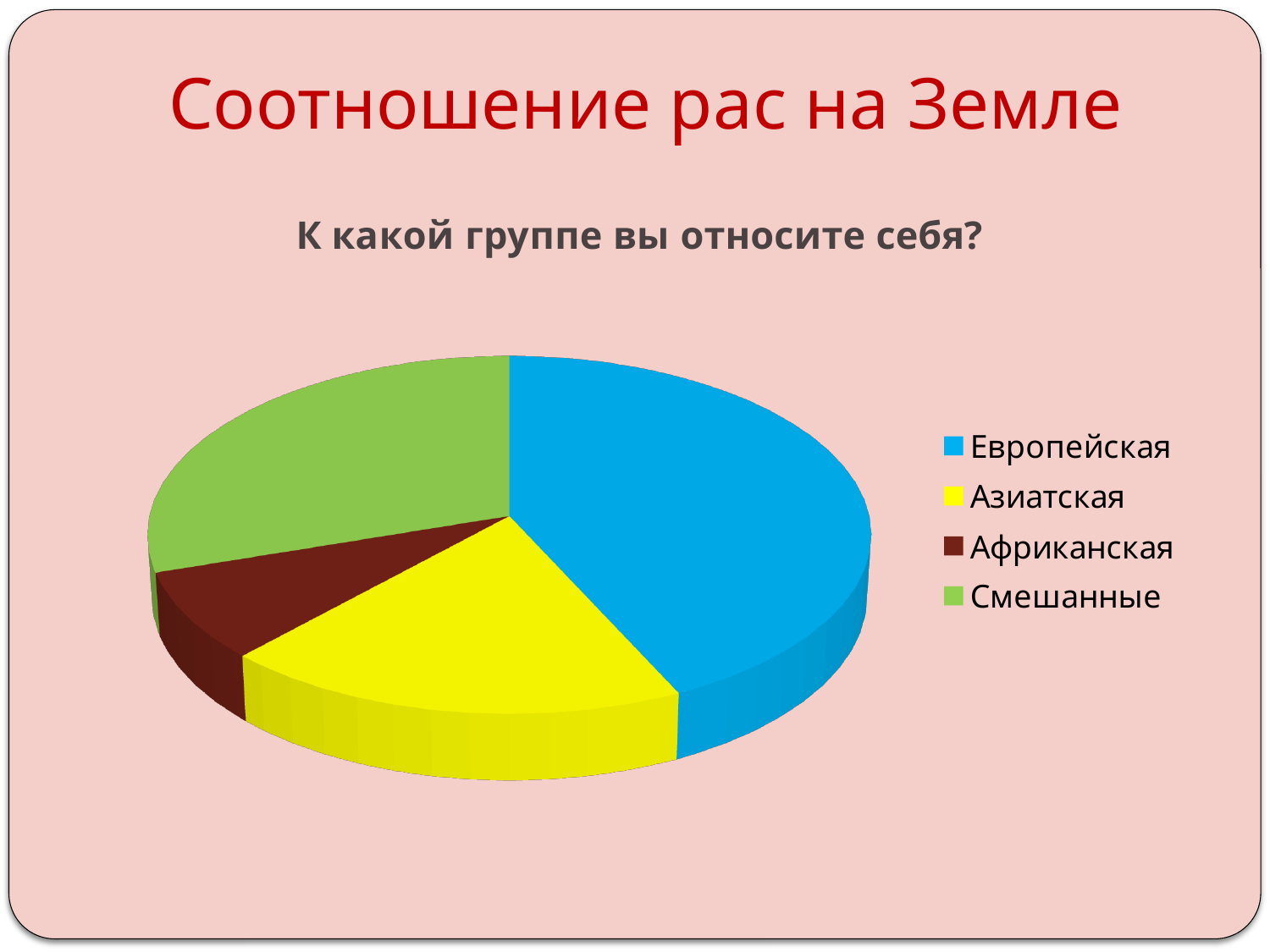
Which slice is larger, Европейская or Африканская? Европейская Which slice is larger, Азиатская or Африканская? Азиатская Which slice is larger, Смешанные or Африканская? Смешанные What kind of chart is shown on the slide? pie chart Which category has the smallest slice of the pie? Африканская What is the title of the chart? К какой группе вы относите себя? Which category has the largest slice of the pie? Европейская How many categories does the pie chart show? 4 What colour represents the Смешанные category in the chart? green How many entries does the legend list? 4